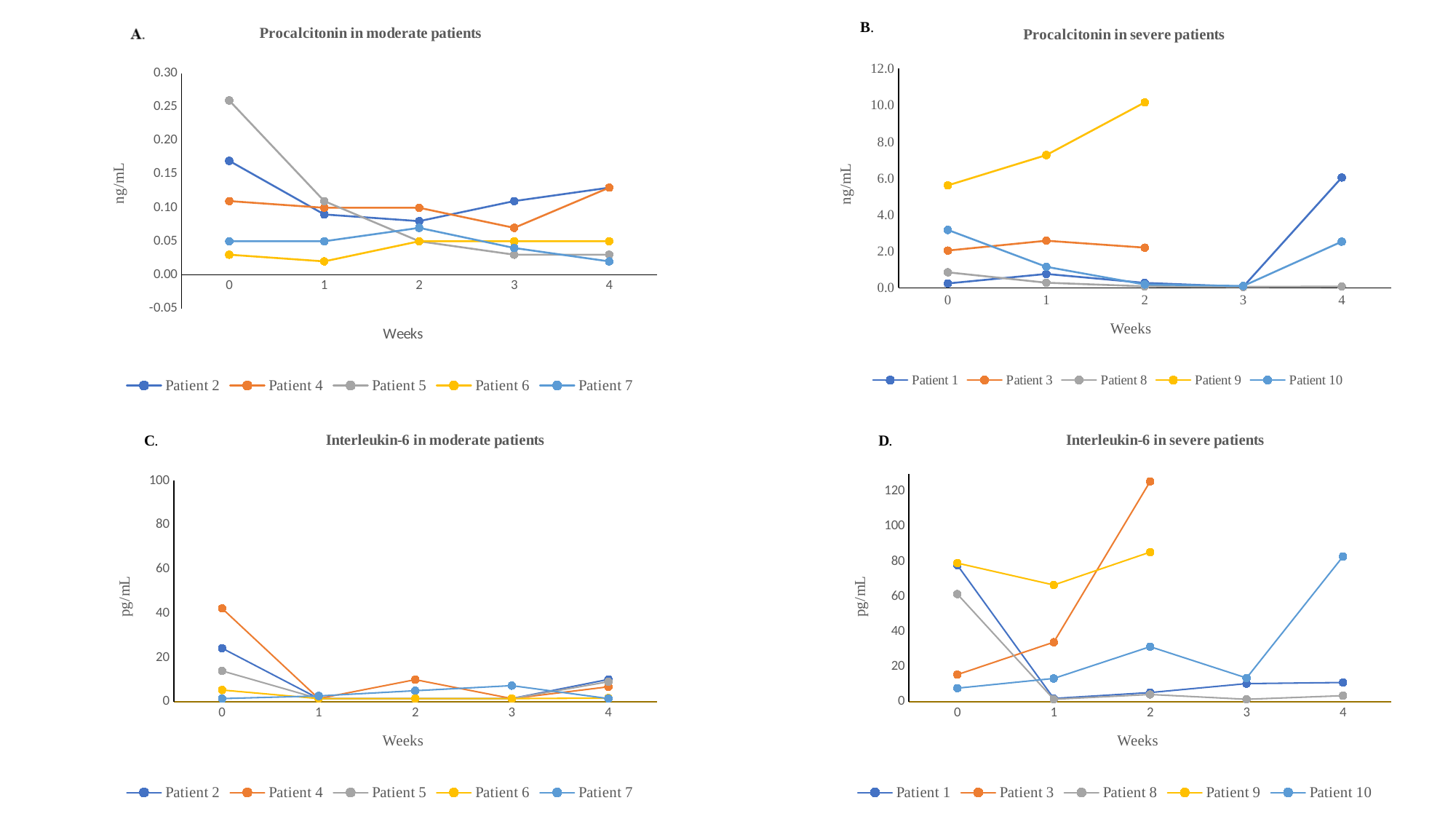
In chart A, "Procalcitonin in moderate patients", which patient has the highest value at week 0? Patient 5 What is the y-axis unit label of chart D, "Interleukin-6 in severe patients"? pg/mL In chart A, "Procalcitonin in moderate patients", does the value for Patient 5 rise or fall from week 0 to week 4? fall In chart A, "Procalcitonin in moderate patients", how many series does the legend list? 5 What kind of chart is chart A, "Procalcitonin in moderate patients"? line chart In chart D, "Interleukin-6 in severe patients", is the value for Patient 3 at week 2 greater or less than 100? greater In chart A, "Procalcitonin in moderate patients", is the value for Patient 5 at week 0 greater or less than 0.20? greater In chart B, "Procalcitonin in severe patients", does the value for Patient 9 rise or fall from week 0 to week 2? rise In chart C, "Interleukin-6 in moderate patients", how many week points are plotted on the x axis? 5 In chart B, "Procalcitonin in severe patients", which patient has the highest value at week 2? Patient 9 In chart B, "Procalcitonin in severe patients", is the value for Patient 9 at week 2 greater or less than 8.0? greater In chart C, "Interleukin-6 in moderate patients", which patient has the highest value at week 0? Patient 4